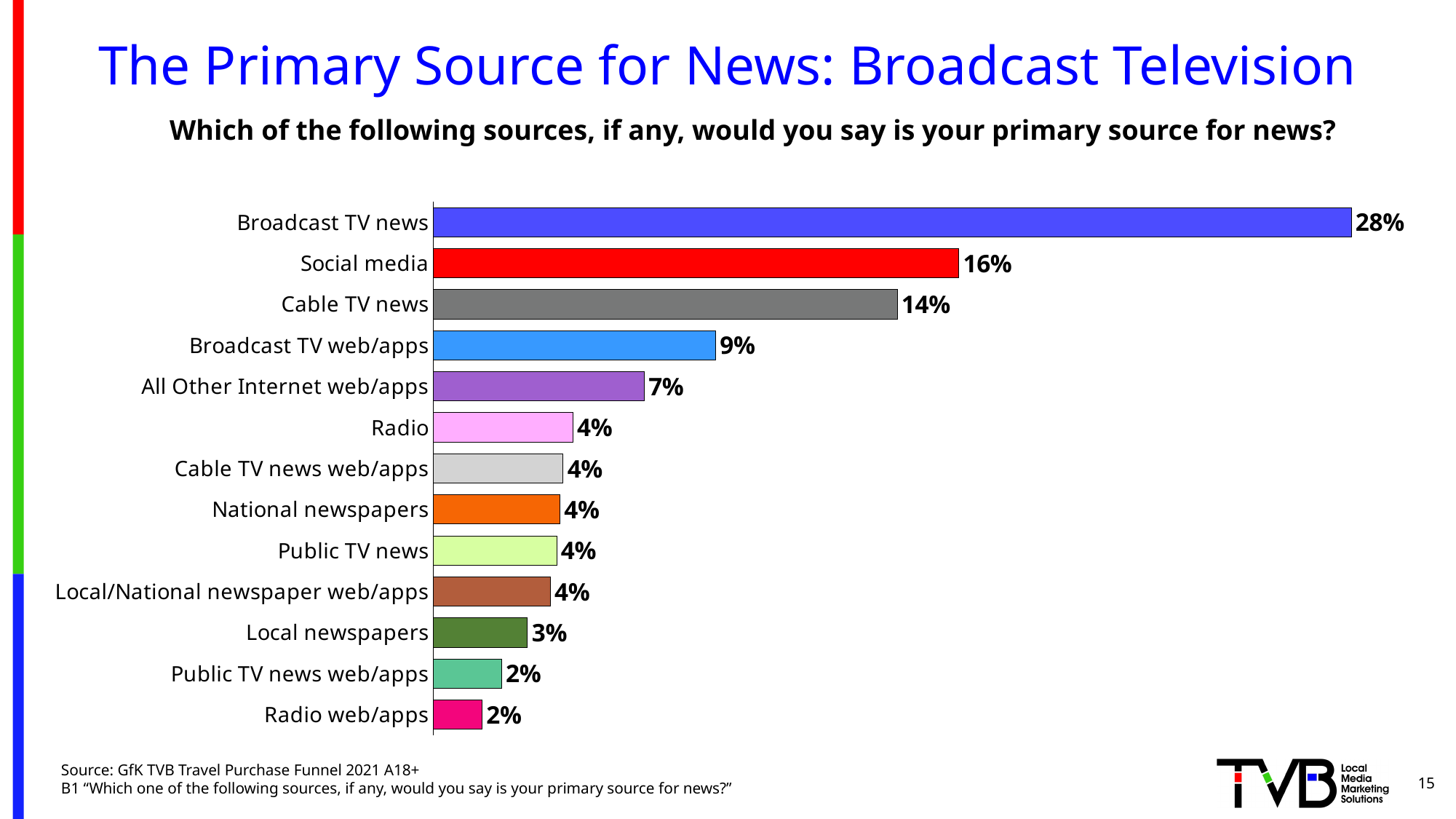
How many sources are listed in the chart? 13 What is the value shown for Social media? 16% What kind of chart is shown on the slide? Bar chart What percentage of respondents say Broadcast TV news is their primary source for news? 28% What is the value shown for Local newspapers? 3% What is the difference in percentage points between Cable TV news and Broadcast TV web/apps? 5 Which is larger, the value for Social media or the value for Cable TV news? Social media Which source has the highest percentage? Broadcast TV news What is the difference in percentage points between Broadcast TV news and Social media? 12 What colour is the bar for Social media? Red What is the value shown for Cable TV news? 14% What is the value shown for All Other Internet web/apps? 7%